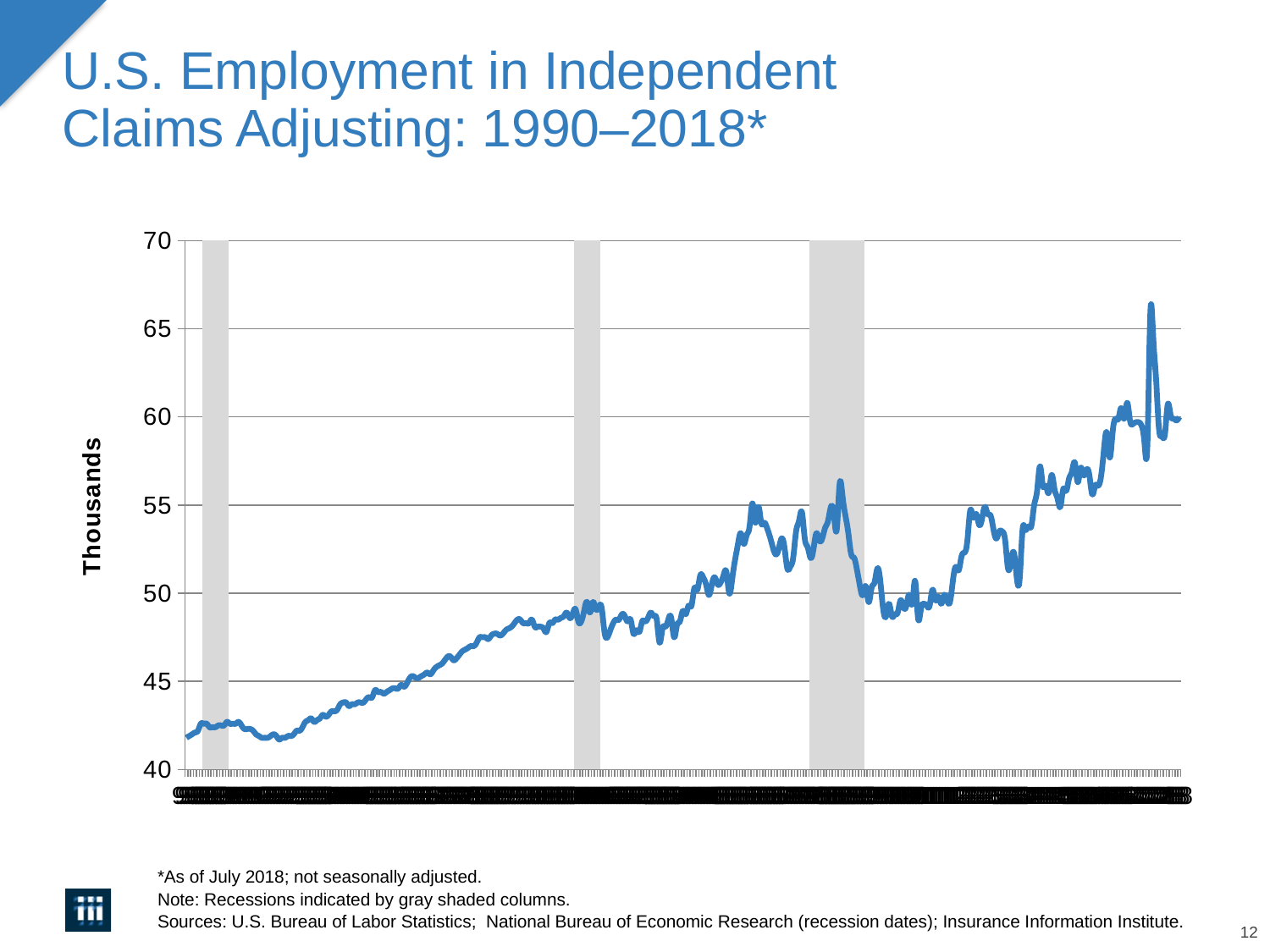
Is the value at the end of the line (far right) greater or less than 55? greater Is the value at the end of the line (far right) larger or smaller than the value at the start of the line (far left)? larger What is the label on the vertical axis of the chart? Thousands What is the lowest value shown on the vertical axis? 40 What kind of chart is shown on the slide? line chart Is the lowest point on the line greater or less than 45? less What is the title of the chart on the slide? U.S. Employment in Independent Claims Adjusting: 1990–2018* Is the highest point reached by the line greater or less than 65? greater How many gray shaded recession columns are shown on the chart? 3 Overall, do the values on the line rise or fall from the left of the chart to the right? rise